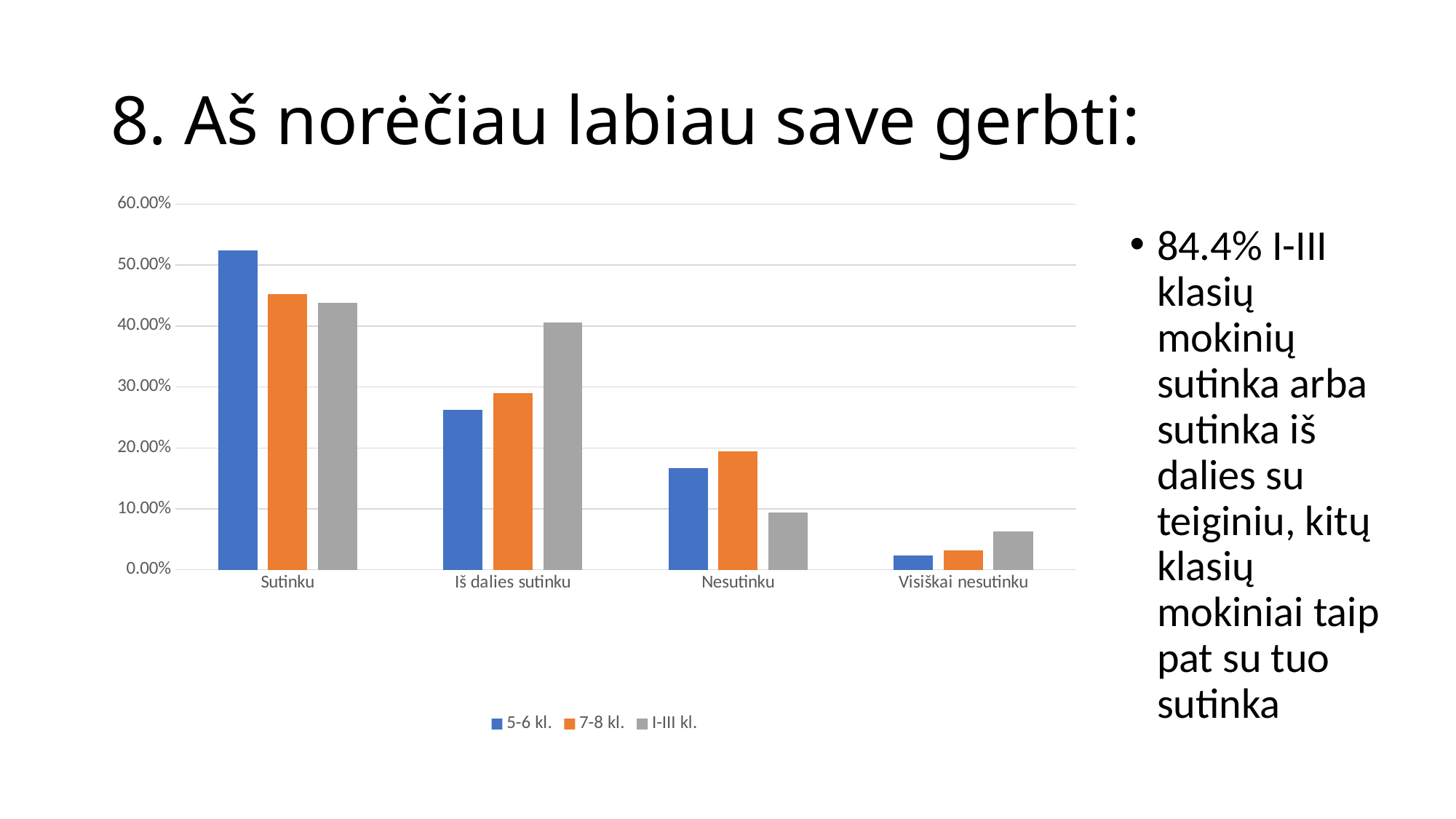
In the Nesutinku category, which series has the larger value: 7-8 kl. or I-III kl.? 7-8 kl. In the Iš dalies sutinku category, which series has the larger value: 5-6 kl. or I-III kl.? I-III kl. What kind of chart is shown on the slide? bar chart What are the three entries listed in the chart legend? 5-6 kl., 7-8 kl., I-III kl. Which category has the highest value for the 5-6 kl. series? Sutinku How many response categories are shown on the x axis? 4 Is the value for 7-8 kl. in the Nesutinku category greater or less than 10.00%? greater Which category has the lowest value for the I-III kl. series? Visiškai nesutinku Is the value for 5-6 kl. in the Sutinku category greater or less than 50.00%? greater Do the values for the 5-6 kl. series rise or fall from Sutinku to Visiškai nesutinku along the x axis? fall How many series does the legend list? 3 Is the value for I-III kl. in the Iš dalies sutinku category greater or less than 30.00%? greater